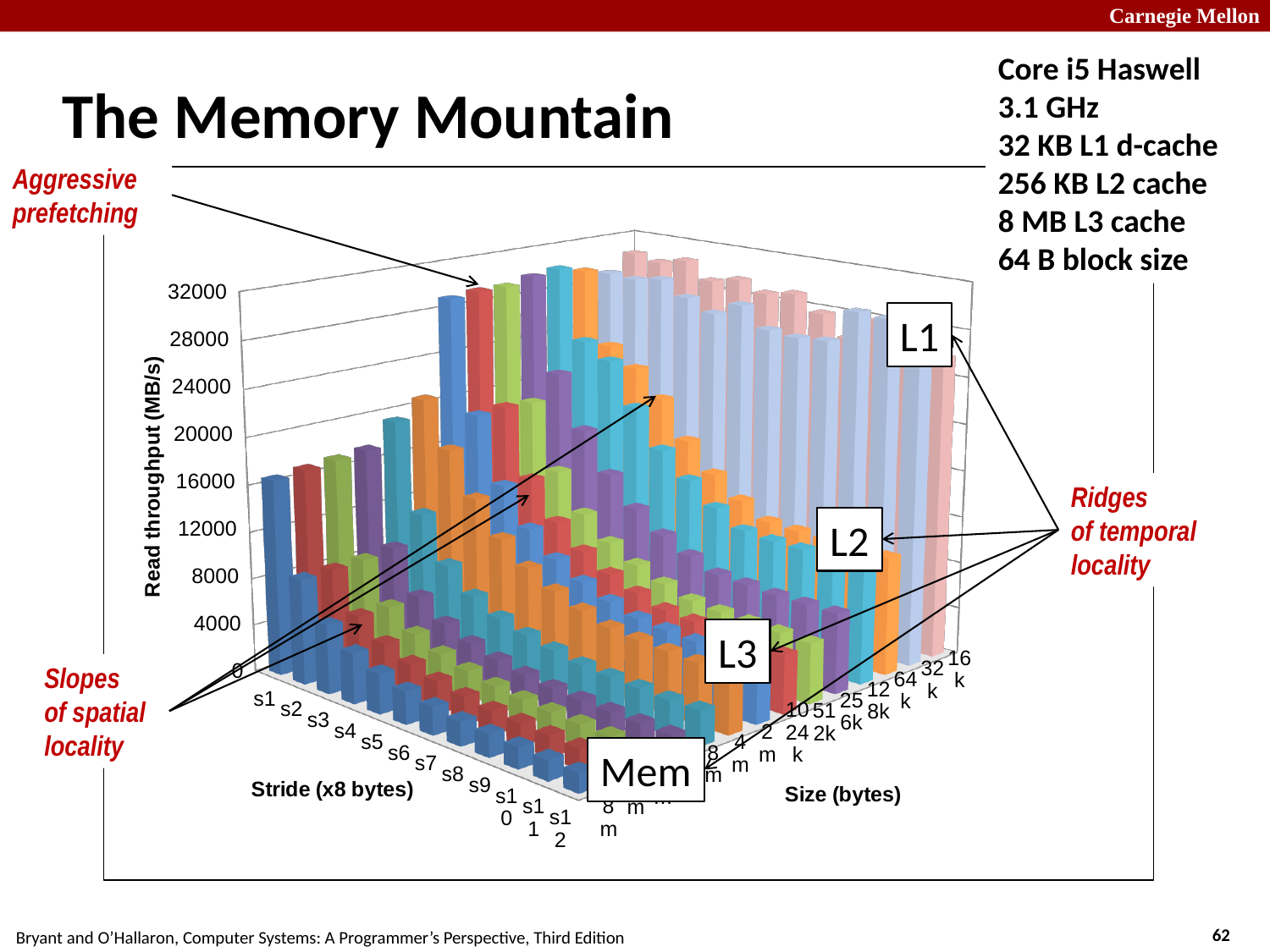
What is the label of the stride axis? Stride (x8 bytes) How many stride categories (s1 through s12) are shown along the stride axis? 12 What is the highest tick value shown on the vertical axis? 32000 What kind of chart is shown on the slide? 3D bar chart What is the label of the vertical axis of the chart? Read throughput (MB/s) What is the interval between consecutive tick marks on the vertical axis? 4000 What is the title of the slide's chart? The Memory Mountain As the stride increases from s1 to s12 for a given size, does read throughput rise or fall? fall